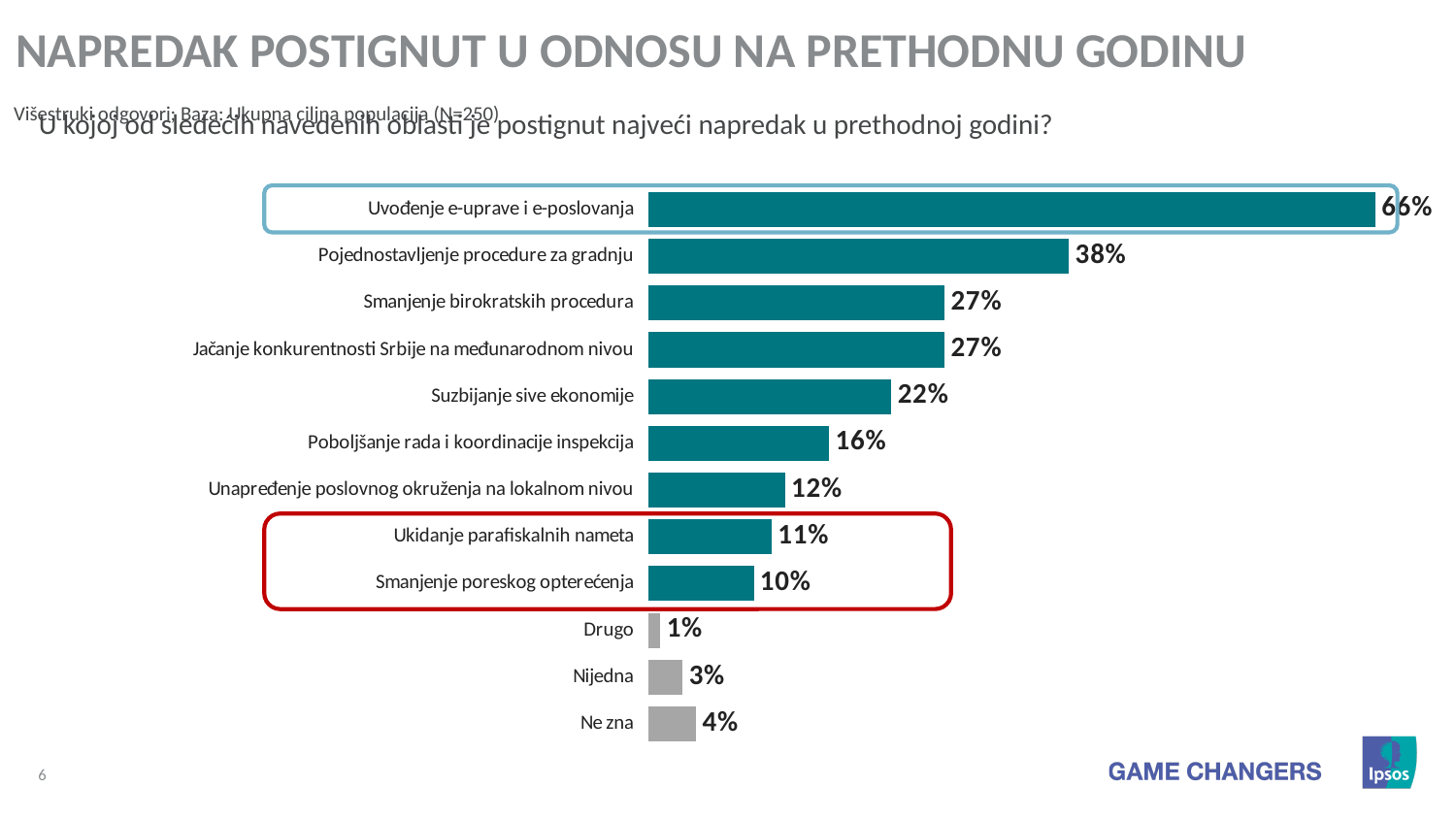
What kind of chart is shown on the slide? Bar chart What is the value for "Pojednostavljenje procedure za gradnju"? 38% What is the value for "Uvođenje e-uprave i e-poslovanja"? 66% What is the difference between the values for "Ukidanje parafiskalnih nameta" and "Smanjenje poreskog opterećenja"? 1% What is the value for "Smanjenje poreskog opterećenja"? 10% Which is larger, the value for "Poboljšanje rada i koordinacije inspekcija" or the value for "Unapređenje poslovnog okruženja na lokalnom nivou"? Poboljšanje rada i koordinacije inspekcija What is the value for "Suzbijanje sive ekonomije"? 22% Which category has the lowest value? Drugo What is the difference between the values for "Uvođenje e-uprave i e-poslovanja" and "Pojednostavljenje procedure za gradnju"? 28% Which two categories are enclosed in the red outline on the chart? Ukidanje parafiskalnih nameta and Smanjenje poreskog opterećenja Which category has the highest value? Uvođenje e-uprave i e-poslovanja How many categories are shown in the chart? 12